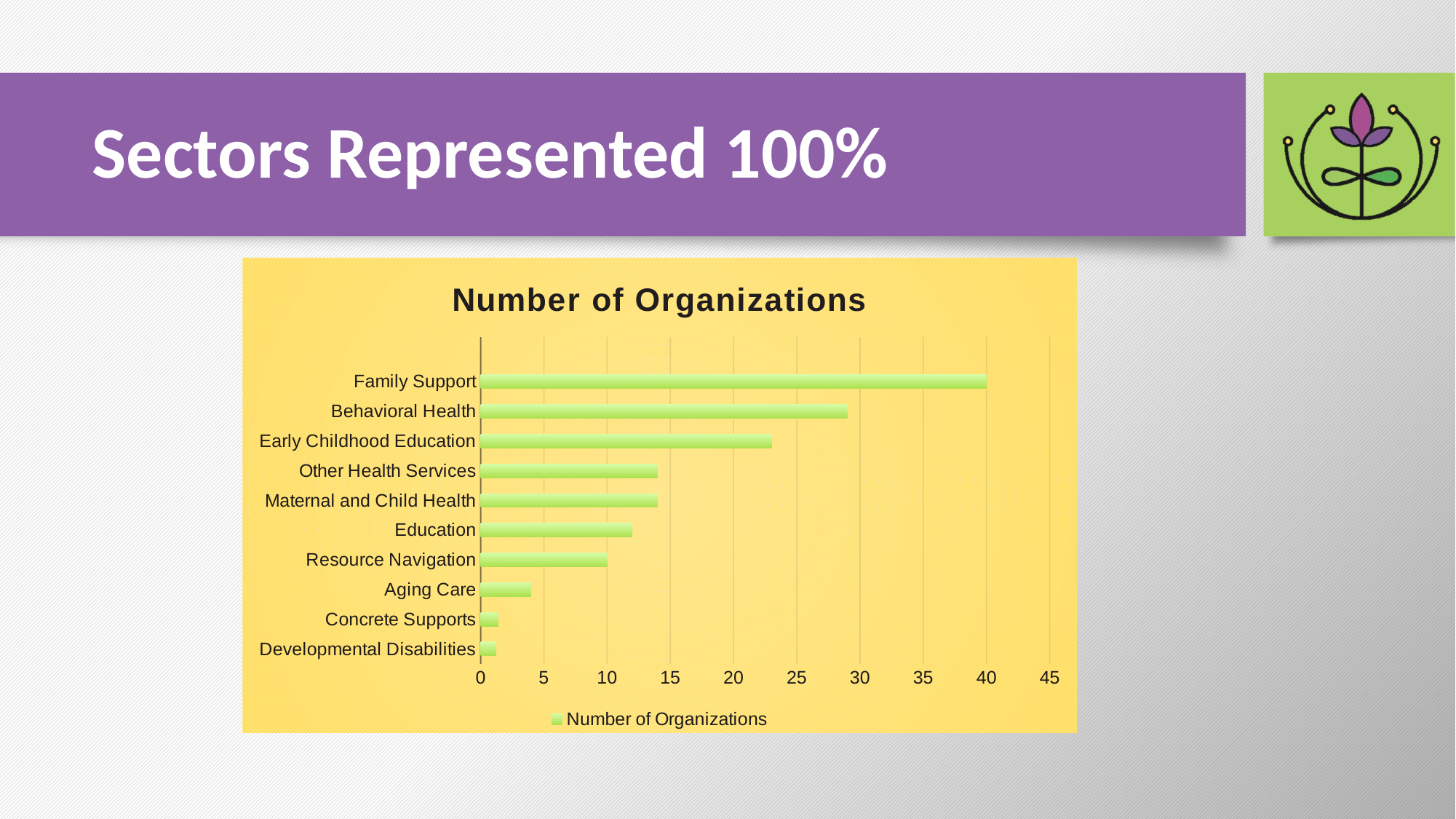
Is the value for Early Childhood Education greater or less than 25? less What is the title of the chart? Number of Organizations What is the number of organizations for Family Support? 40 How many series does the legend list? 1 Which sector has the highest number of organizations? Family Support Which has more organizations, Behavioral Health or Early Childhood Education? Behavioral Health Is the value for Behavioral Health greater or less than 25? greater Is the value for Other Health Services greater or less than 15? less What type of chart is shown on the slide? bar chart Which has more organizations, Aging Care or Concrete Supports? Aging Care How many sectors (categories) are shown in the chart? 10